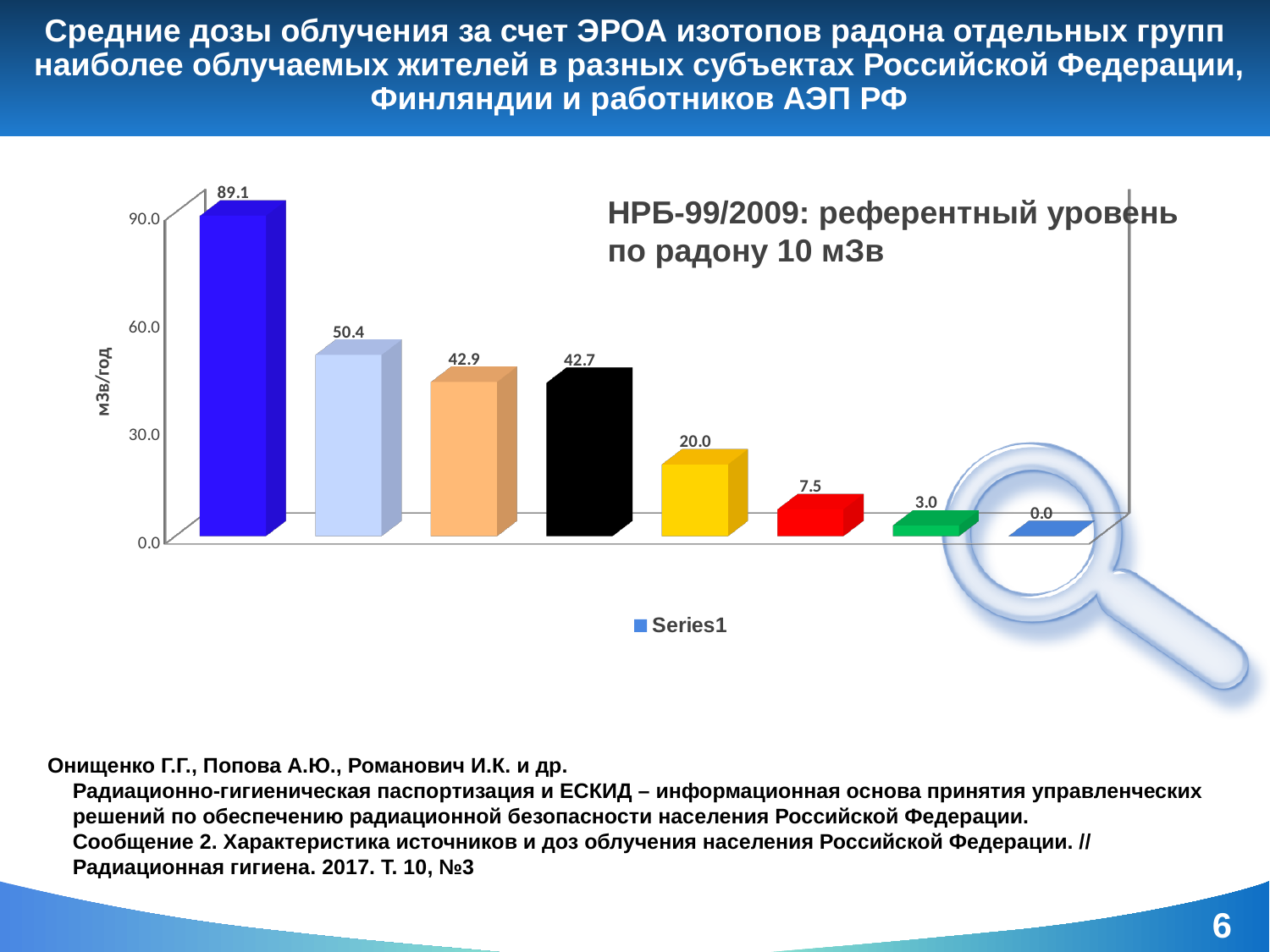
What is the label on the vertical axis of the chart? мЗв/год How many bars are plotted in the chart? 8 What type of chart is shown on the slide? bar chart What is the difference between the values of the leftmost bar (89.1) and the second bar (50.4)? 38.7 What is the value shown on the black bar? 42.7 How many series does the chart legend list? 1 What is the value shown on the red bar? 7.5 What is the value shown on the second bar from the left (light blue)? 50.4 What is the value shown on the orange bar? 42.9 Which is larger: the value of the green bar or the value of the red bar? the red bar (7.5) What is the value shown on the yellow bar? 20.0 What is the value shown on the tallest (dark blue, leftmost) bar? 89.1